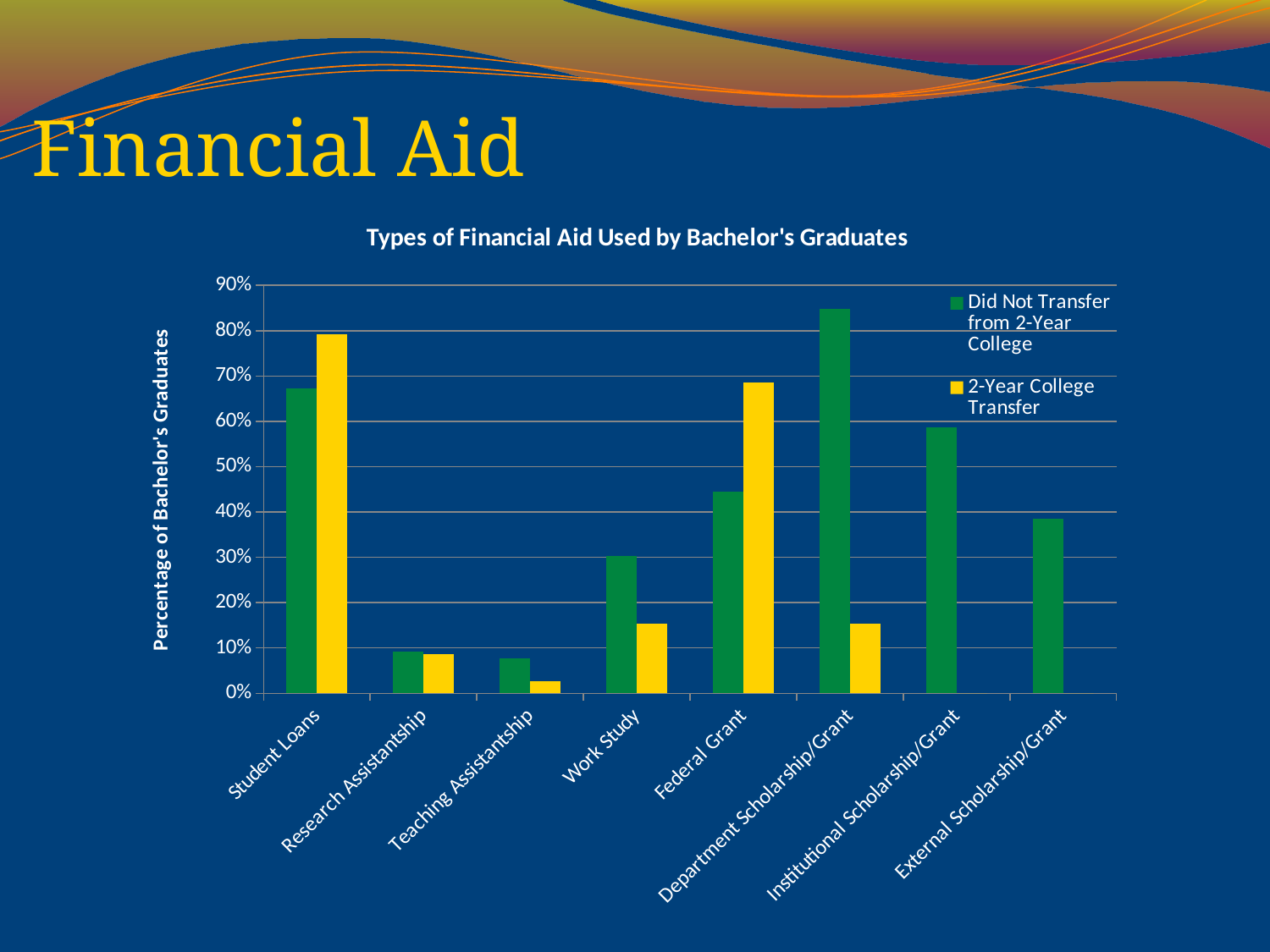
For Department Scholarship/Grant, which series has the larger value: 'Did Not Transfer from 2-Year College' or '2-Year College Transfer'? Did Not Transfer from 2-Year College Is the value for Federal Grant in the '2-Year College Transfer' series greater or less than 60%? greater Is the value for Department Scholarship/Grant in the 'Did Not Transfer from 2-Year College' series greater or less than 80%? greater Is the value for Work Study in the 'Did Not Transfer from 2-Year College' series greater or less than 40%? less Which category has the highest value for the '2-Year College Transfer' series? Student Loans Which category has the highest value for the 'Did Not Transfer from 2-Year College' series? Department Scholarship/Grant How many series does the legend list? 2 What type of chart is shown on the slide? bar chart What is the title of the chart? Types of Financial Aid Used by Bachelor's Graduates How many financial aid categories are shown on the x axis? 8 For Student Loans, which series has the larger value: 'Did Not Transfer from 2-Year College' or '2-Year College Transfer'? 2-Year College Transfer